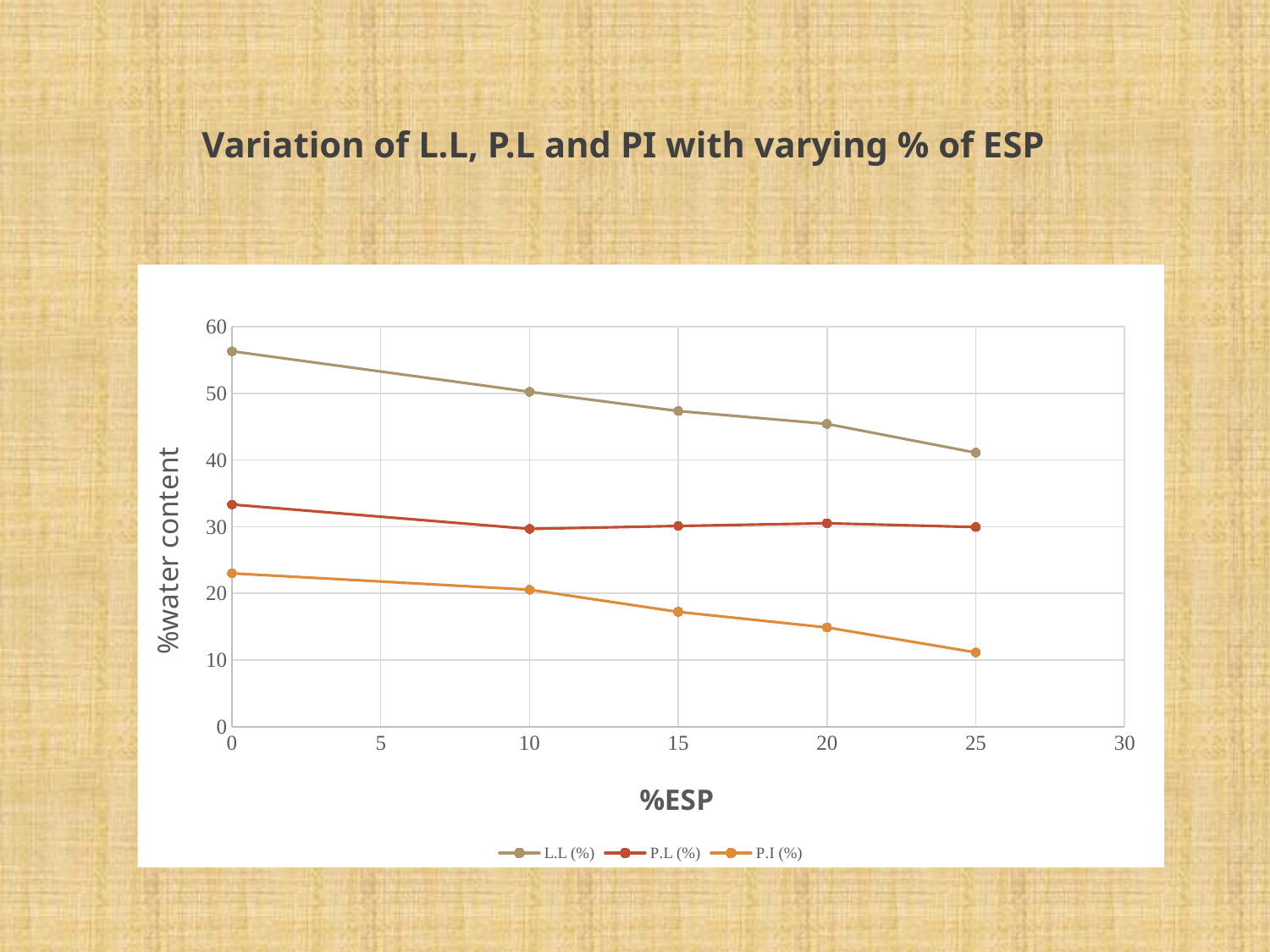
How many series does the legend list? 3 Is the value of P.L (%) at 10 %ESP greater or less than 40? less For the L.L (%) series, is the value larger at 0 %ESP or at 25 %ESP? 0 %ESP Does the L.L (%) series rise or fall as %ESP increases from 0 to 25? fall Does the P.I (%) series rise or fall as %ESP increases from 0 to 25? fall What kind of chart is shown on the slide? line chart Which series has the highest value at 25 %ESP? L.L (%) Is the value of L.L (%) at 0 %ESP greater or less than 50? greater What is the title of the x axis? %ESP How many data points are plotted for the L.L (%) series? 5 Is the value of P.I (%) at 25 %ESP greater or less than 20? less Which series has the lowest value at 0 %ESP? P.I (%)